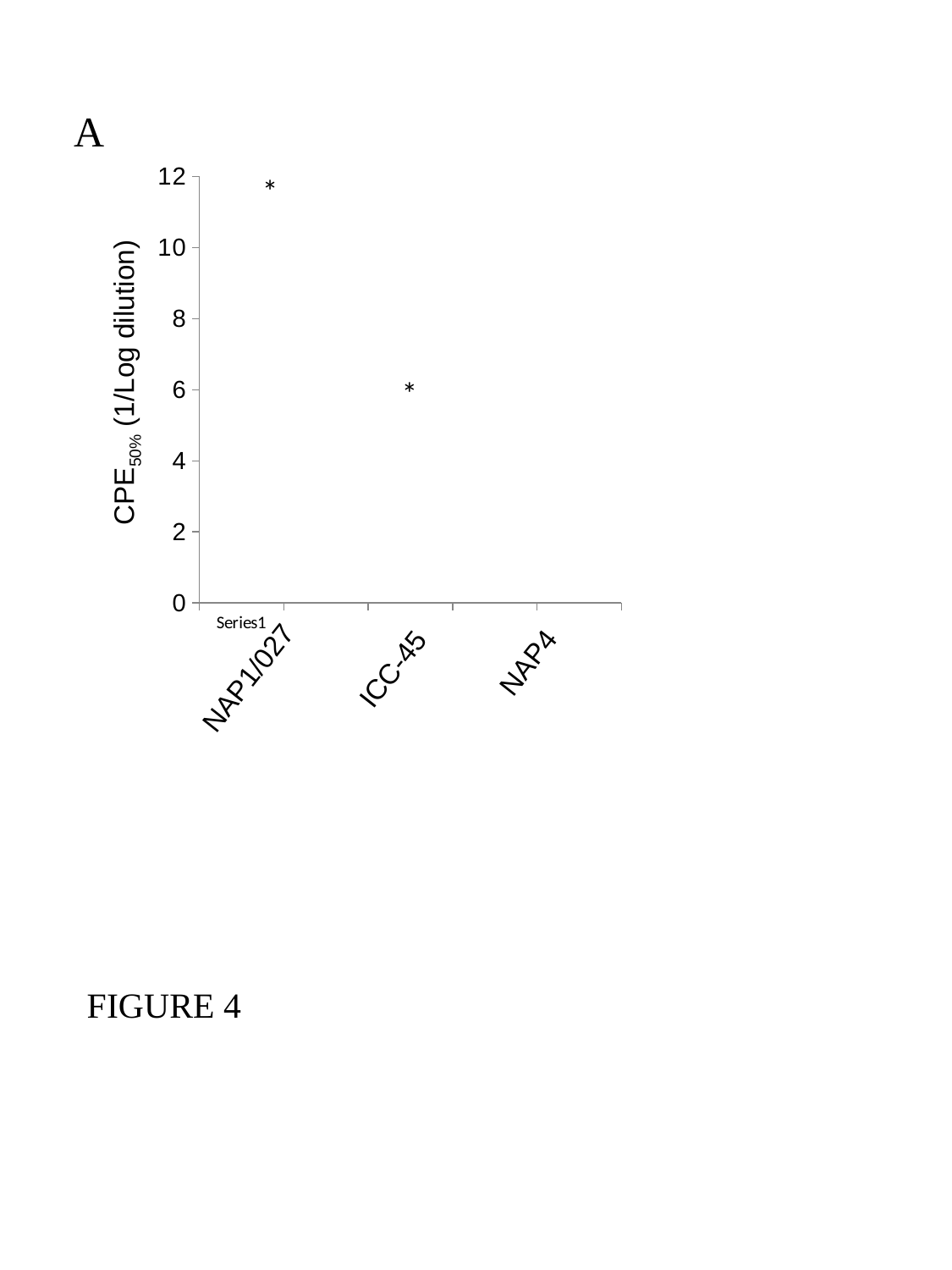
What is the highest tick value shown on the y axis? 12 Which category has the highest value on the chart? NAP1/027 How many asterisk markers are plotted on the chart? 2 Which has the larger value, NAP1/027 or ICC-45? NAP1/027 Is the value for NAP1/027 greater or less than 6? greater How many categories are labelled on the x axis? 3 Do the plotted values rise or fall from NAP1/027 to ICC-45? fall Is the value for ICC-45 greater or less than 8? less Is the value for NAP1/027 greater or less than 10? greater What is the label of the y axis? CPE50% (1/Log dilution)